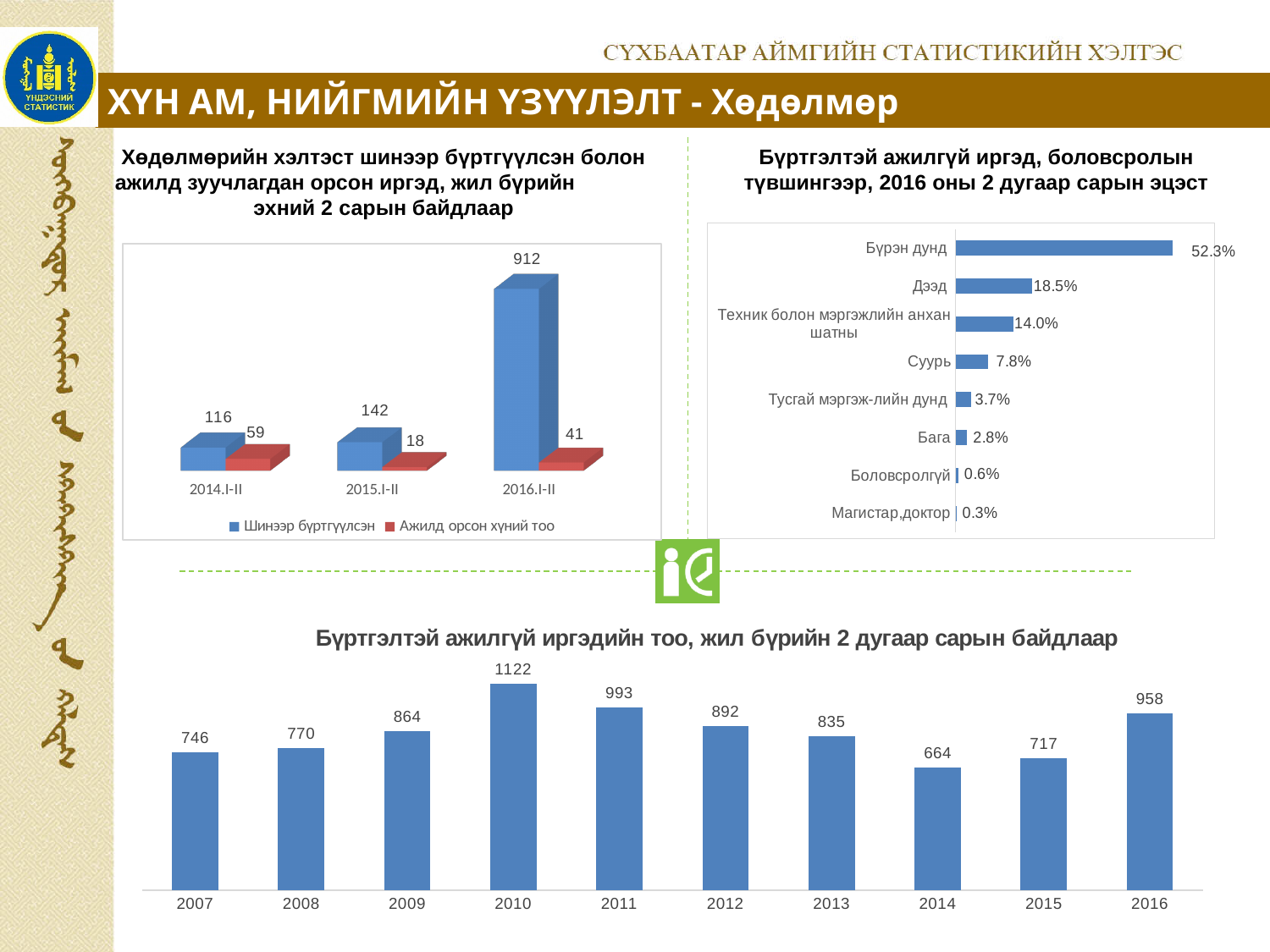
In the top-right chart (Бүртгэлтэй ажилгүй иргэд, боловсролын түвшингээр), which category has the highest value? Бүрэн дунд In the bottom chart (Бүртгэлтэй ажилгүй иргэдийн тоо), do the values rise or fall from 2007 to 2010? rise In the top-right chart (Бүртгэлтэй ажилгүй иргэд, боловсролын түвшингээр), which is larger: Суурь or Бага? Суурь In the bottom chart (Бүртгэлтэй ажилгүй иргэдийн тоо), what is the difference between the values for 2016 and 2015? 241 In the top-left chart (Хөдөлмөрийн хэлтэст шинээр бүртгүүлсэн...), what is the value of Шинээр бүртгүүлсэн for 2016.I-II? 912 In the top-left chart (Хөдөлмөрийн хэлтэст шинээр бүртгүүлсэн...), how many series does the legend list? 2 In the bottom chart (Бүртгэлтэй ажилгүй иргэдийн тоо), what is the value for 2010? 1122 In the top-right chart (Бүртгэлтэй ажилгүй иргэд, боловсролын түвшингээр), how many education categories are listed? 8 In the top-left chart (Хөдөлмөрийн хэлтэст шинээр бүртгүүлсэн...), what is the difference between Шинээр бүртгүүлсэн and Ажилд орсон хүний тоо for 2015.I-II? 124 In the bottom chart (Бүртгэлтэй ажилгүй иргэдийн тоо), which year has the lowest value? 2014 In the top-right chart (Бүртгэлтэй ажилгүй иргэд, боловсролын түвшингээр), what is the value for Дээд? 18.5% In the bottom chart (Бүртгэлтэй ажилгүй иргэдийн тоо), how many years are shown on the x axis? 10